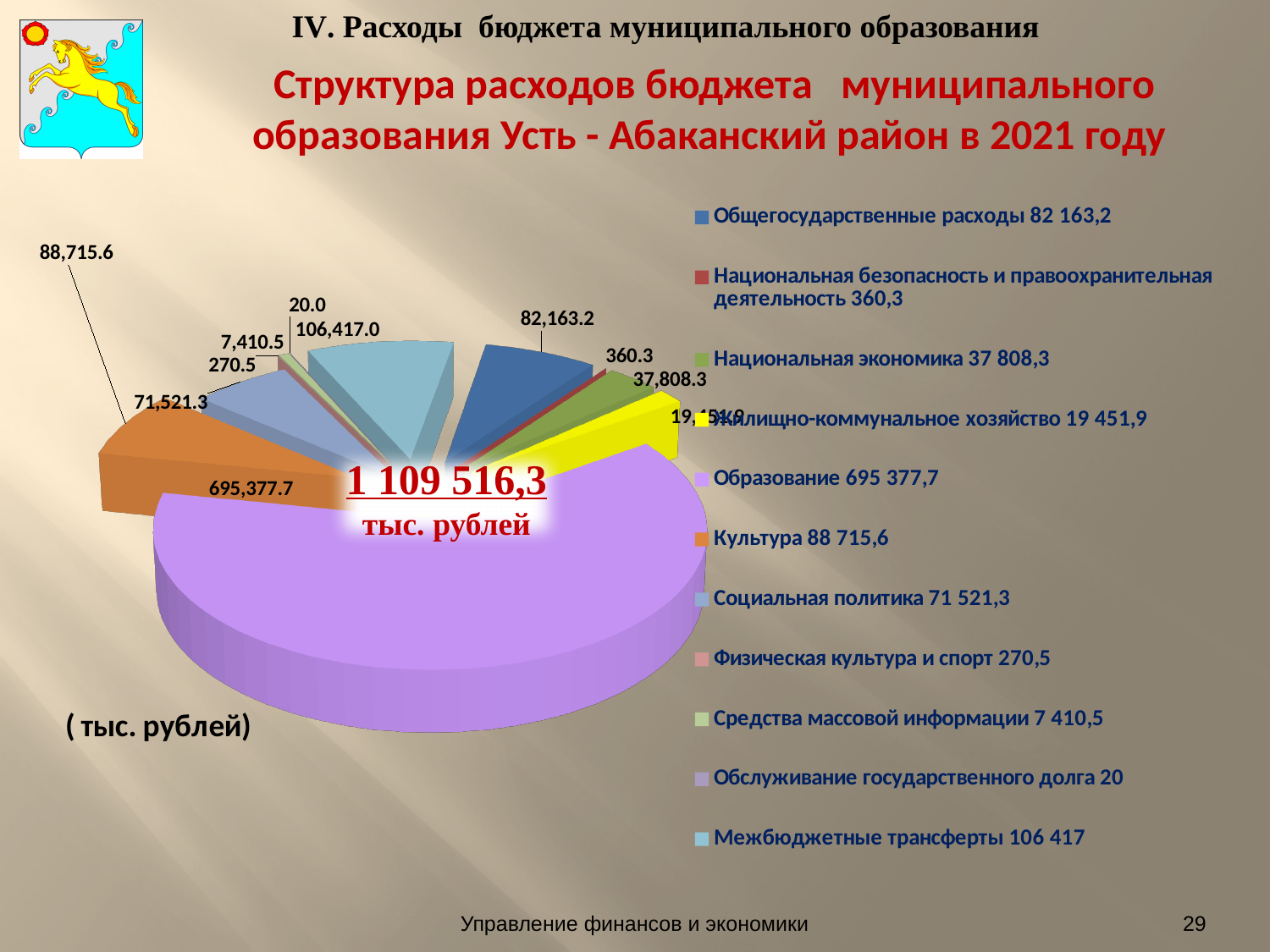
Which category has the largest slice of the pie chart? Образование What is the value shown for Физическая культура и спорт? 270.5 What total amount is printed in the centre of the pie chart? 1 109 516,3 тыс. рублей How many expenditure categories does the legend of the pie chart list? 11 What is the value shown for Межбюджетные трансферты? 106,417.0 What is the value shown for Культура? 88,715.6 What is the value shown for Национальная экономика? 37,808.3 Which category has the smallest value in the pie chart? Обслуживание государственного долга Which is larger, Социальная политика or Межбюджетные трансферты? Межбюджетные трансферты Which is larger, Общегосударственные расходы or Культура? Культура What kind of chart is shown on the slide? Pie chart What is the difference between Общегосударственные расходы (82,163.2) and Социальная политика (71,521.3)? 10,641.9